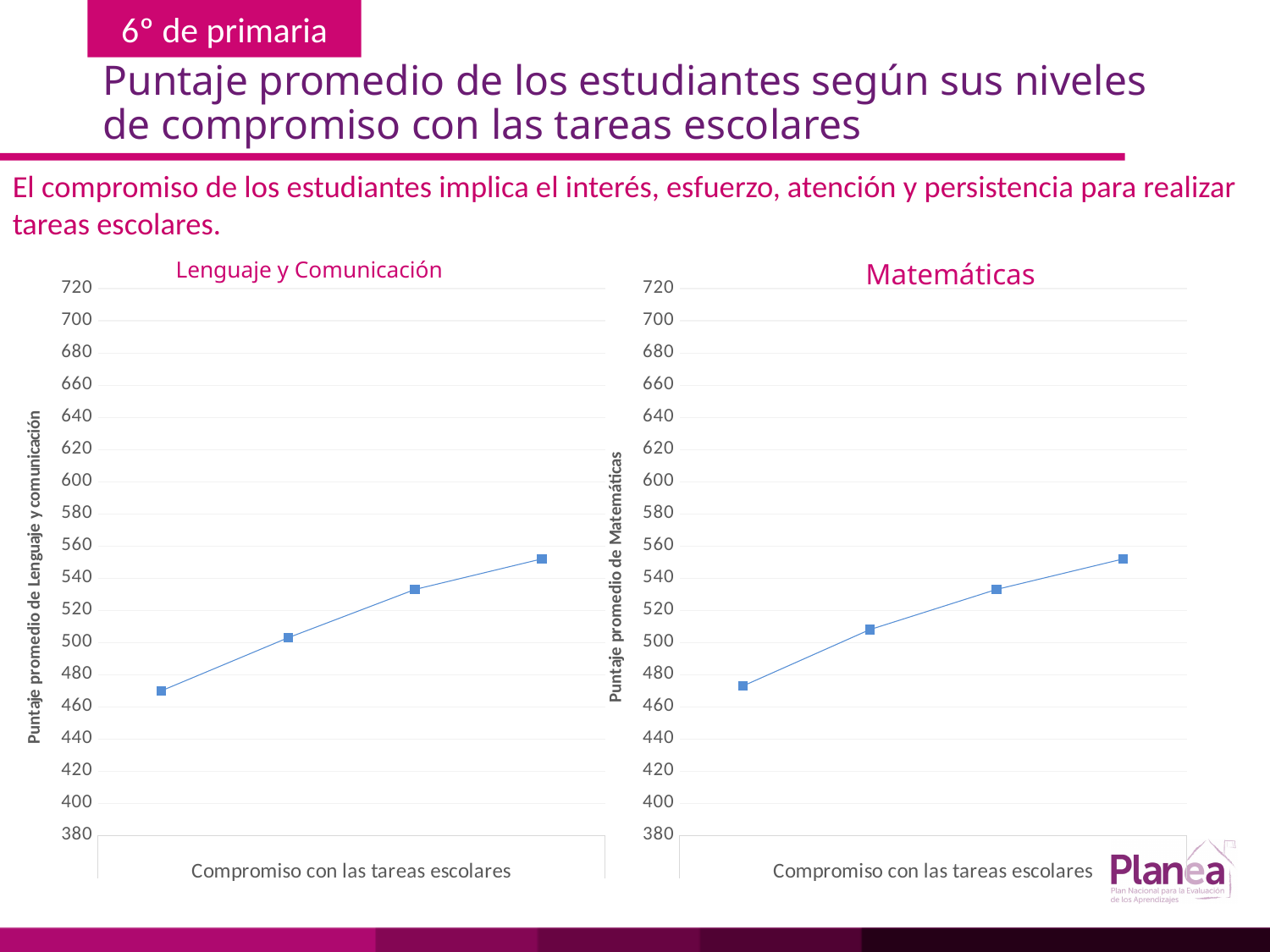
What is the y-axis title of the Lenguaje y Comunicación chart? Puntaje promedio de Lenguaje y comunicación What is the x-axis title of the Matemáticas chart? Compromiso con las tareas escolares In the Lenguaje y Comunicación chart, is the value of the rightmost point greater or less than 540? greater What kind of chart is the Lenguaje y Comunicación chart? line chart In the Matemáticas chart, do the values rise or fall from left to right along the x axis? rise In the Lenguaje y Comunicación chart, do the values rise or fall from left to right along the x axis? rise In the Lenguaje y Comunicación chart, is the value of the leftmost point greater or less than 480? less How many data points are plotted in the Matemáticas chart? 4 In the Matemáticas chart, is the value of the leftmost point greater or less than 480? less What kind of chart is the Matemáticas chart? line chart How many data points are plotted in the Lenguaje y Comunicación chart? 4